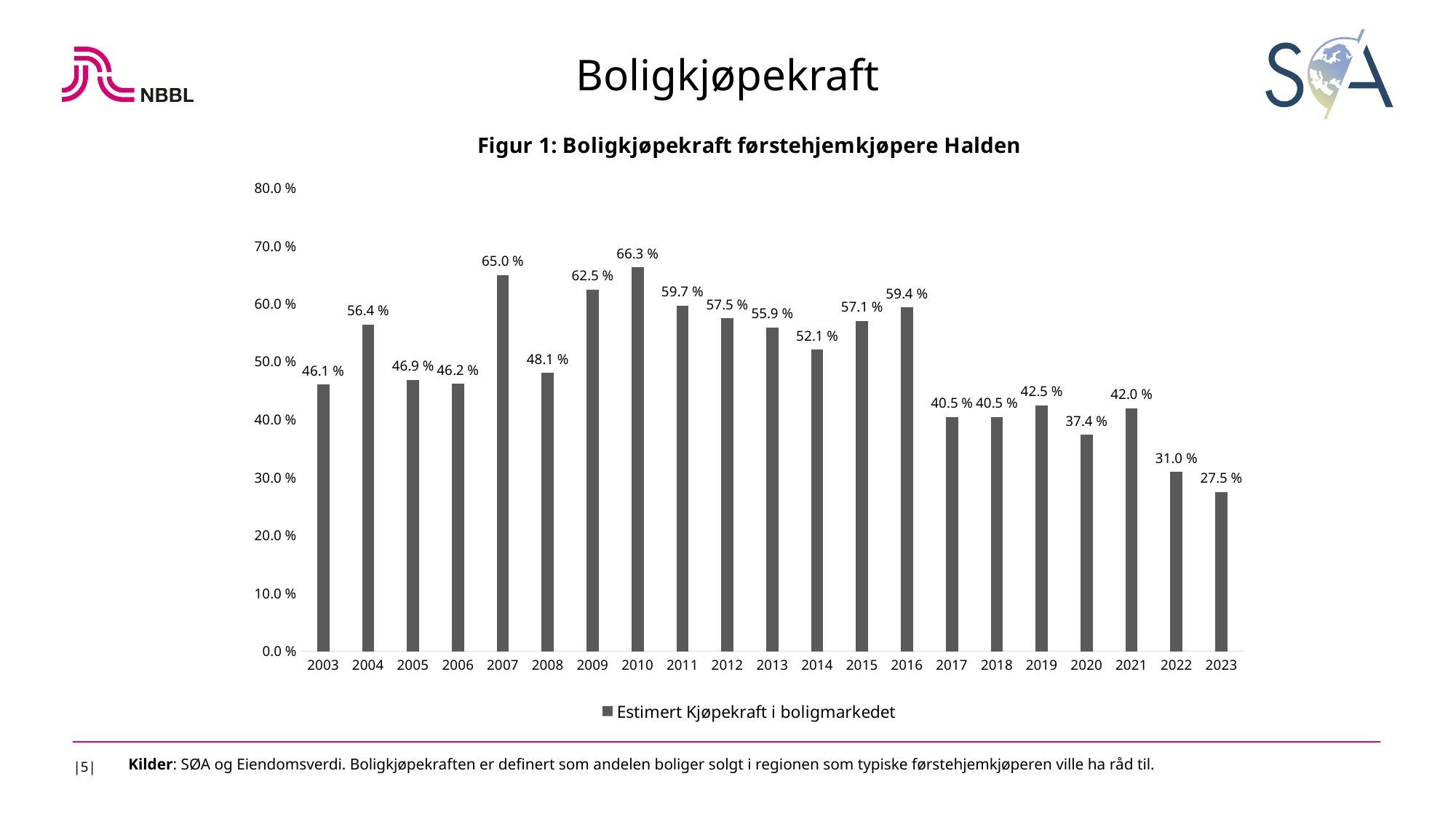
Which year has the highest value? 2010 What is the value for 2010? 66.3 % Which year has the lowest value? 2023 How many series does the legend list? 1 How many years are shown on the x axis? 21 What is the value for 2023? 27.5 % What is the difference between the values for 2010 and 2023? 38.8 % Is the value for 2020 greater or less than 40.0 %? less What is the legend entry for the series? Estimert Kjøpekraft i boligmarkedet What kind of chart is shown? bar chart What is the value for 2014? 52.1 % Which is larger, the value for 2007 or the value for 2009? 2007